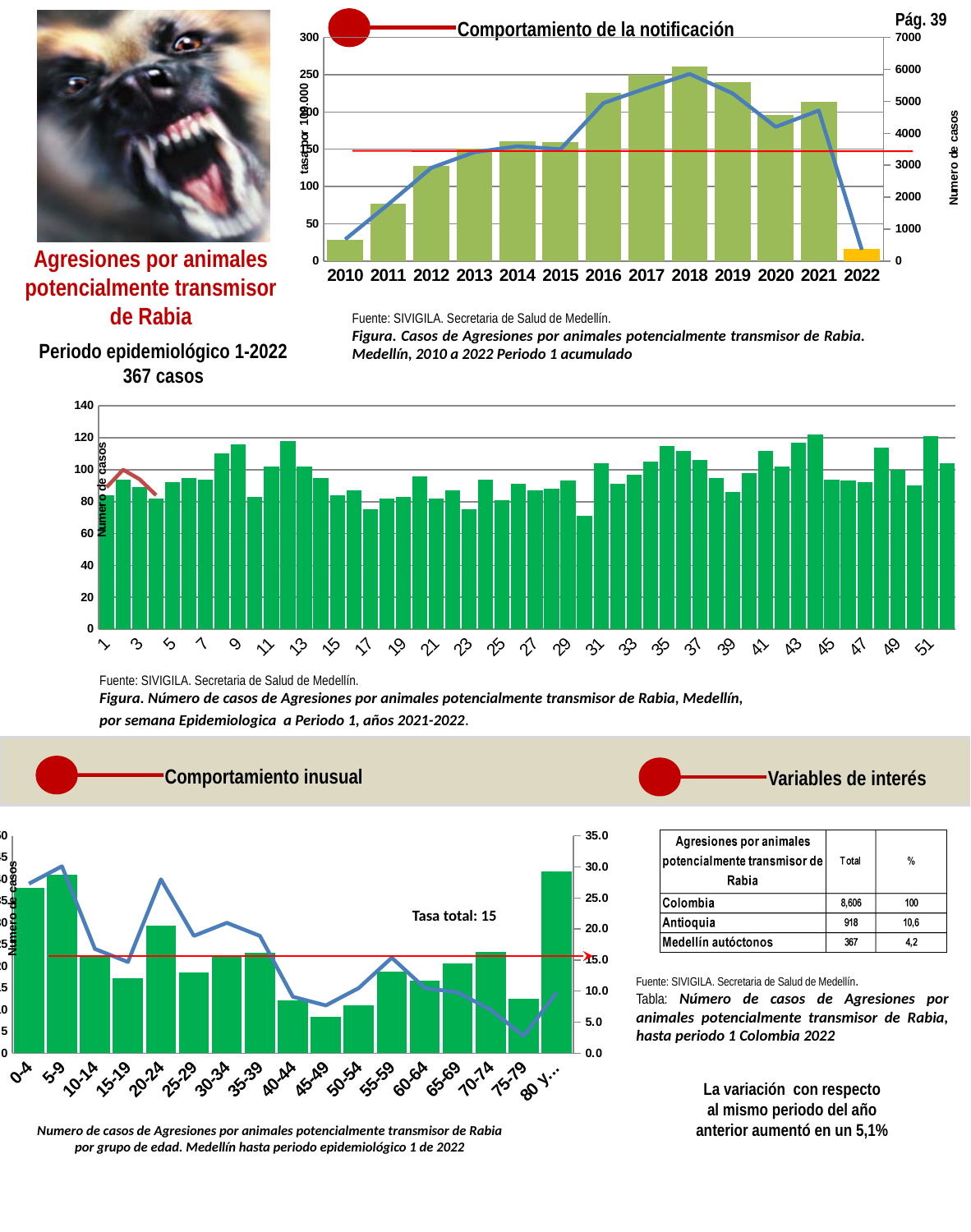
In the middle chart of cases by epidemiological week, is the value for week 30 greater or less than 80? less In the bottom-left chart of cases by age group, which age group has the lowest bar? 45-49 In the top chart 'Comportamiento de la notificación', do the bars rise or fall from 2010 to 2018? rise In the top chart 'Comportamiento de la notificación', which year has the lowest bar? 2022 In the bottom-left chart of cases by age group, which age group has the highest bar? 80 y... What kind of chart is the top chart titled 'Comportamiento de la notificación'? combination bar and line chart In the top chart 'Comportamiento de la notificación', is the number of cases for 2010 greater or less than 1000? less In the top chart 'Comportamiento de la notificación', which year has the taller bar, 2017 or 2014? 2017 In the top chart 'Comportamiento de la notificación', which year has the highest bar? 2018 In the top chart 'Comportamiento de la notificación', how many years are shown on the x axis? 13 In the middle chart of cases by epidemiological week, how many weeks are shown on the x axis? 52